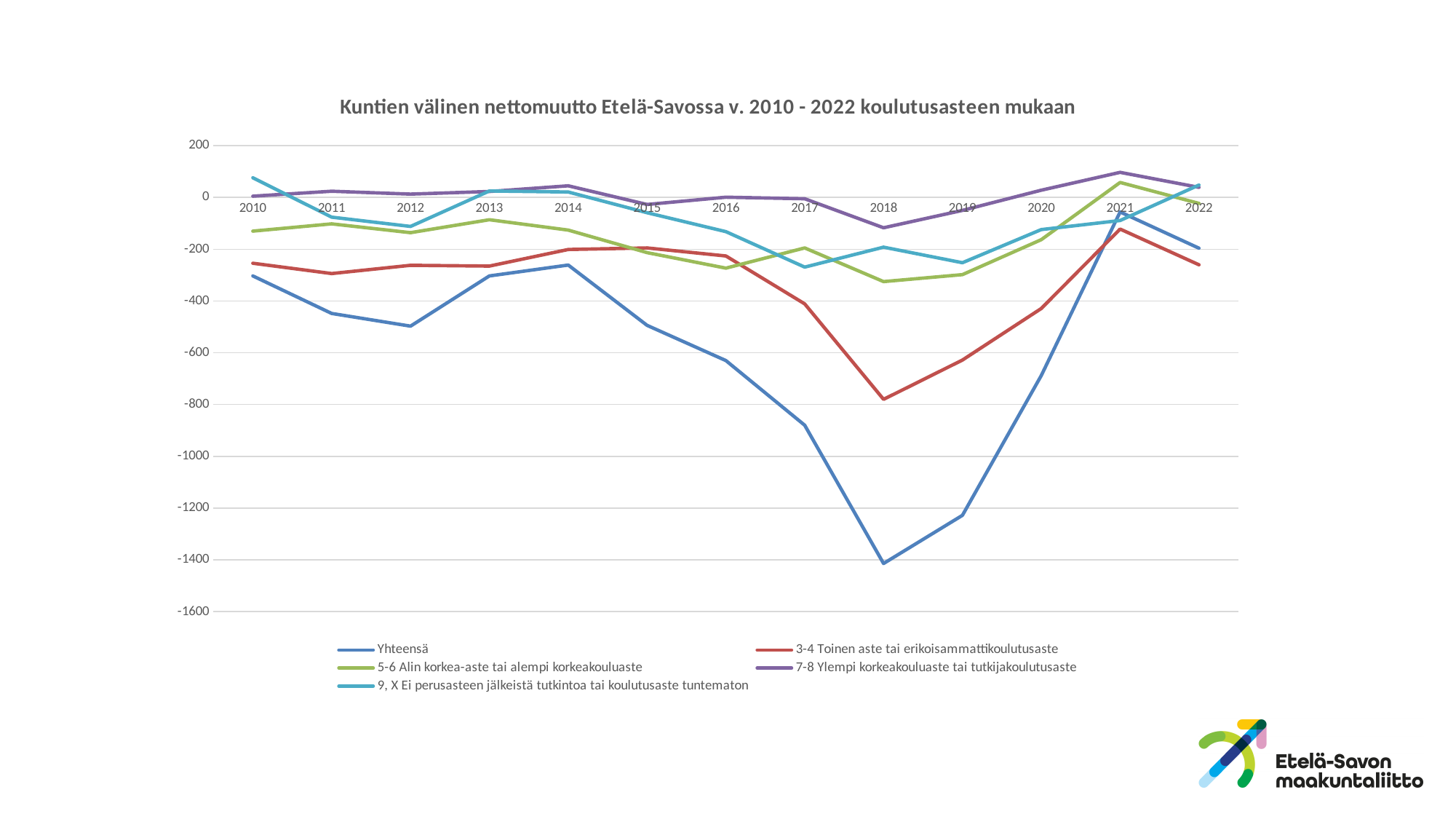
In which year does the 3-4 Toinen aste tai erikoisammattikoulutusaste series reach its lowest value? 2018 In which year does the Yhteensä series reach its lowest value? 2018 In 2018, which series has the higher value: Yhteensä or 3-4 Toinen aste tai erikoisammattikoulutusaste? 3-4 Toinen aste tai erikoisammattikoulutusaste Is the Yhteensä value for 2018 greater or less than -1000? less What is the title of the chart? Kuntien välinen nettomuutto Etelä-Savossa v. 2010 - 2022 koulutusasteen mukaan Does the Yhteensä series rise or fall from 2018 to 2021? rise What kind of chart is shown on the slide? line chart Is the 7-8 Ylempi korkeakouluaste tai tutkijakoulutusaste value for 2021 greater or less than 0? greater How many years are plotted along the x axis? 13 How many series does the legend list? 5 In which year does the Yhteensä series reach its highest value? 2021 Is the 3-4 Toinen aste tai erikoisammattikoulutusaste value for 2018 greater or less than -600? less